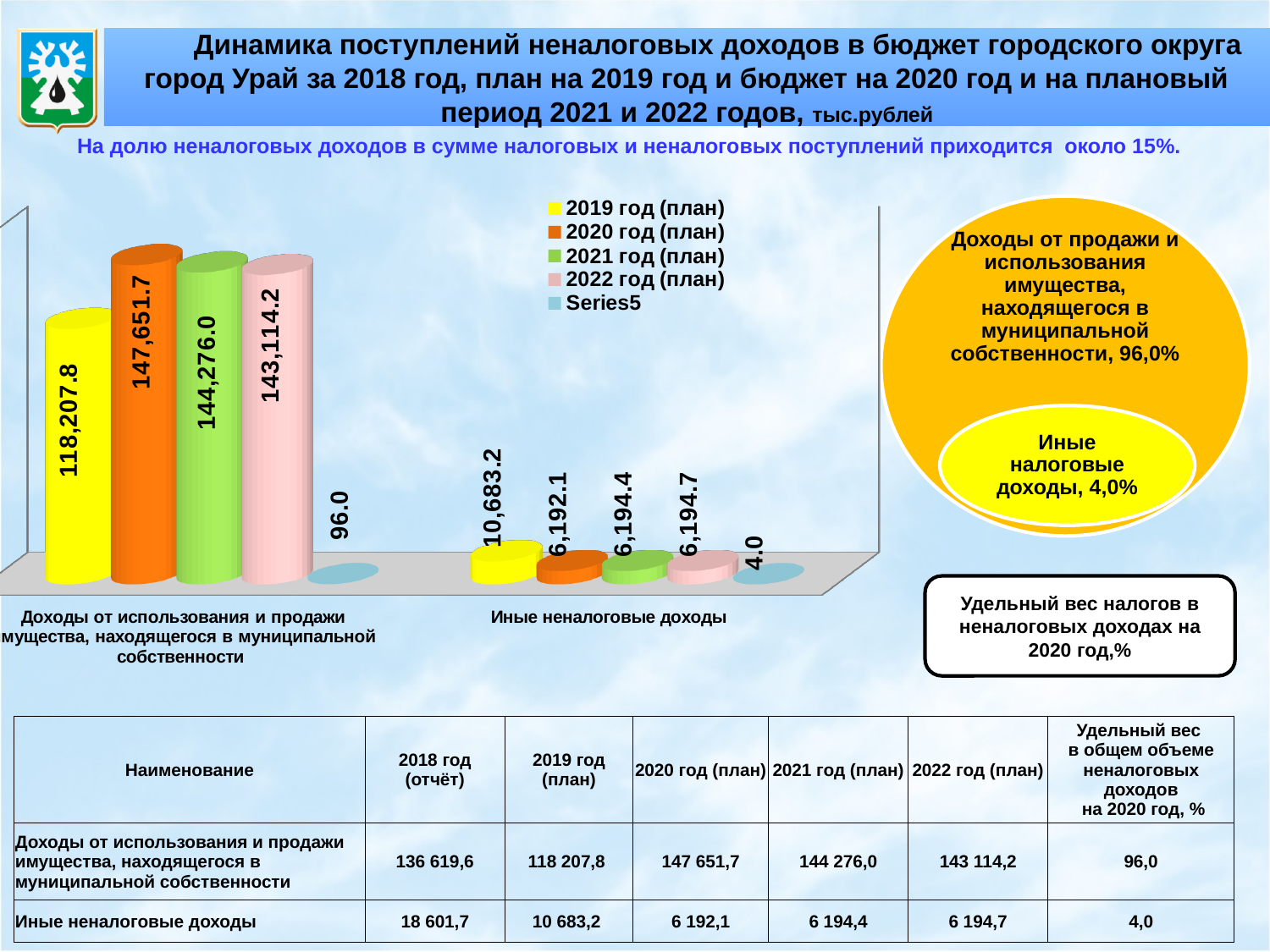
In the bar chart, what is the value for 2022 год (план) for Доходы от использования и продажи имущества, находящегося в муниципальной собственности? 143,114.2 In the bar chart, which series has the highest value for Доходы от использования и продажи имущества, находящегося в муниципальной собственности? 2020 год (план) In the bar chart, what is the value for 2020 год (план) for Иные неналоговые доходы? 6,192.1 In the bar chart, do the values for Доходы от использования и продажи имущества, находящегося в муниципальной собственности rise or fall from 2020 год (план) to 2022 год (план)? fall In the bar chart, what is the difference between the 2020 год (план) and 2019 год (план) values for Доходы от использования и продажи имущества, находящегося в муниципальной собственности? 29,443.9 How many categories are shown on the x axis of the bar chart? 2 In the bar chart, which is larger for Иные неналоговые доходы: the 2019 год (план) value or the 2021 год (план) value? 2019 год (план) How many series does the legend of the bar chart list? 5 In the bar chart, what is the difference between the 2019 год (план) and 2020 год (план) values for Иные неналоговые доходы? 4,491.1 In the bar chart, what is the value for 2019 год (план) for Доходы от использования и продажи имущества, находящегося в муниципальной собственности? 118,207.8 In the bar chart, which of the four year series has the highest value for Иные неналоговые доходы? 2019 год (план)